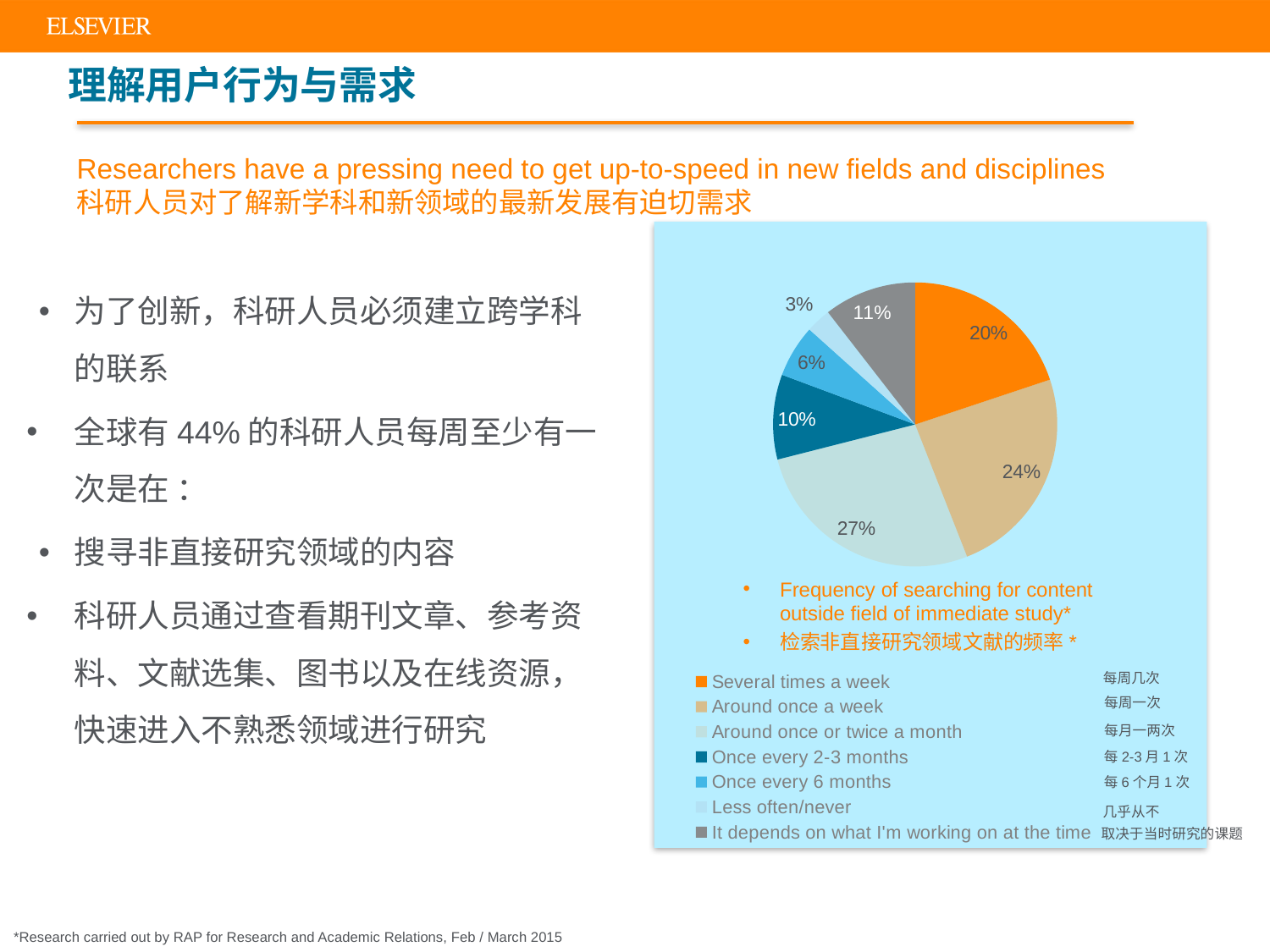
What colour is the slice for 'Several times a week'? orange What percentage of researchers search for content outside their field around once a week? 24% What percentage of researchers search for content outside their field around once or twice a month? 27% What percentage of researchers answered 'It depends on what I'm working on at the time'? 11% Which is larger: the share for 'Several times a week' or the share for 'Once every 2-3 months'? Several times a week What percentage of researchers search for content outside their field once every 2-3 months? 10% What is the difference in percentage points between 'Around once a week' and 'Once every 6 months'? 18 Which category has the largest share of the pie? Around once or twice a month What kind of chart is shown on the slide? pie chart How many categories does the legend of the pie chart list? 7 Which category has the smallest share of the pie? Less often/never What percentage of researchers search for content outside their field several times a week? 20%